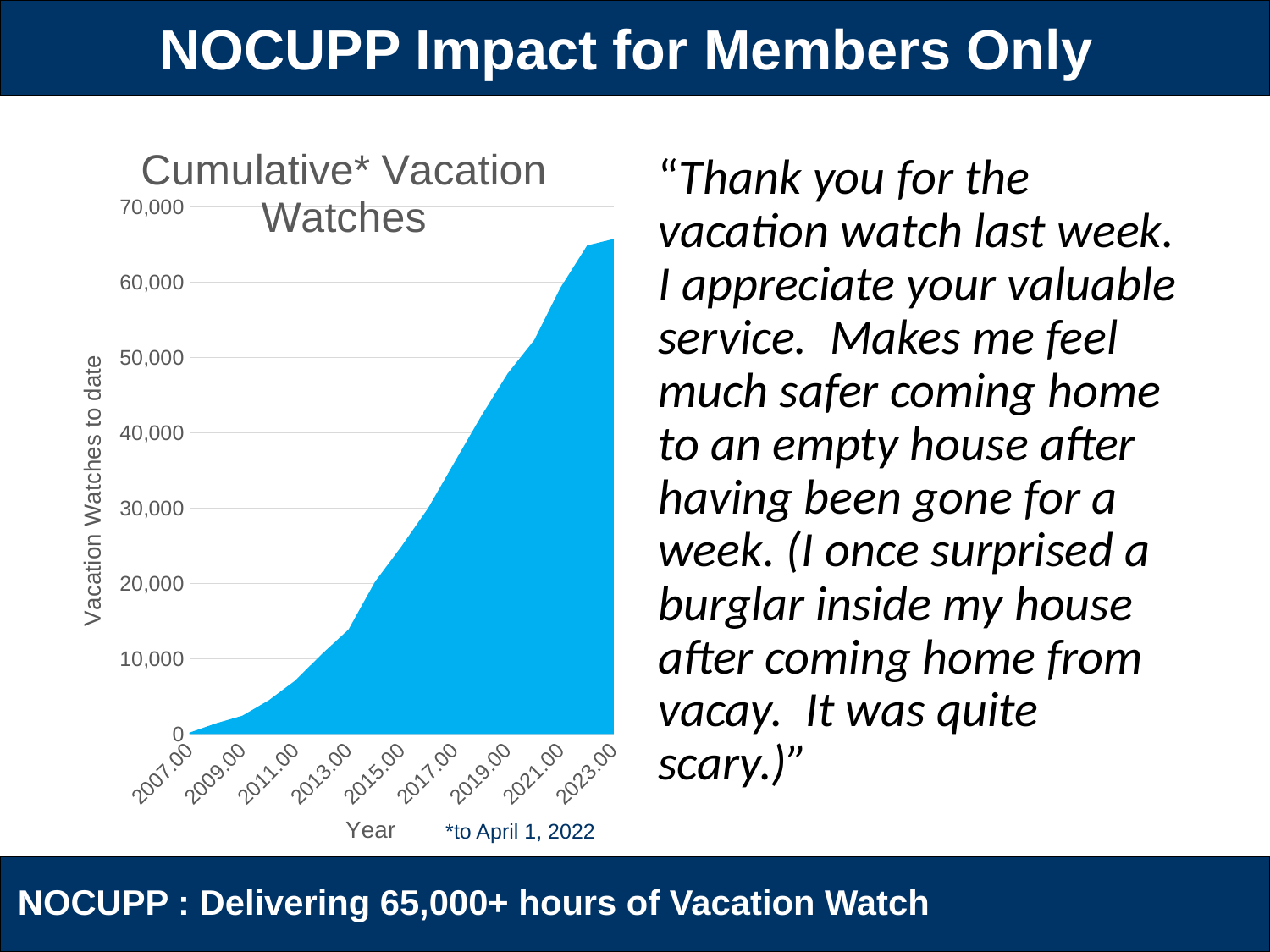
Is the value for 2023.00 greater or less than 70,000? less Is the value for 2013.00 greater or less than 10,000? greater What is the label on the vertical axis of the chart? Vacation Watches to date Is the value for 2015.00 greater or less than 20,000? greater Do the values in the chart rise or fall as the years increase along the x axis? Rise What is the title of the chart? Cumulative* Vacation Watches What kind of chart is shown on the slide? Area chart Which year shown on the x axis has the highest cumulative value? 2023.00